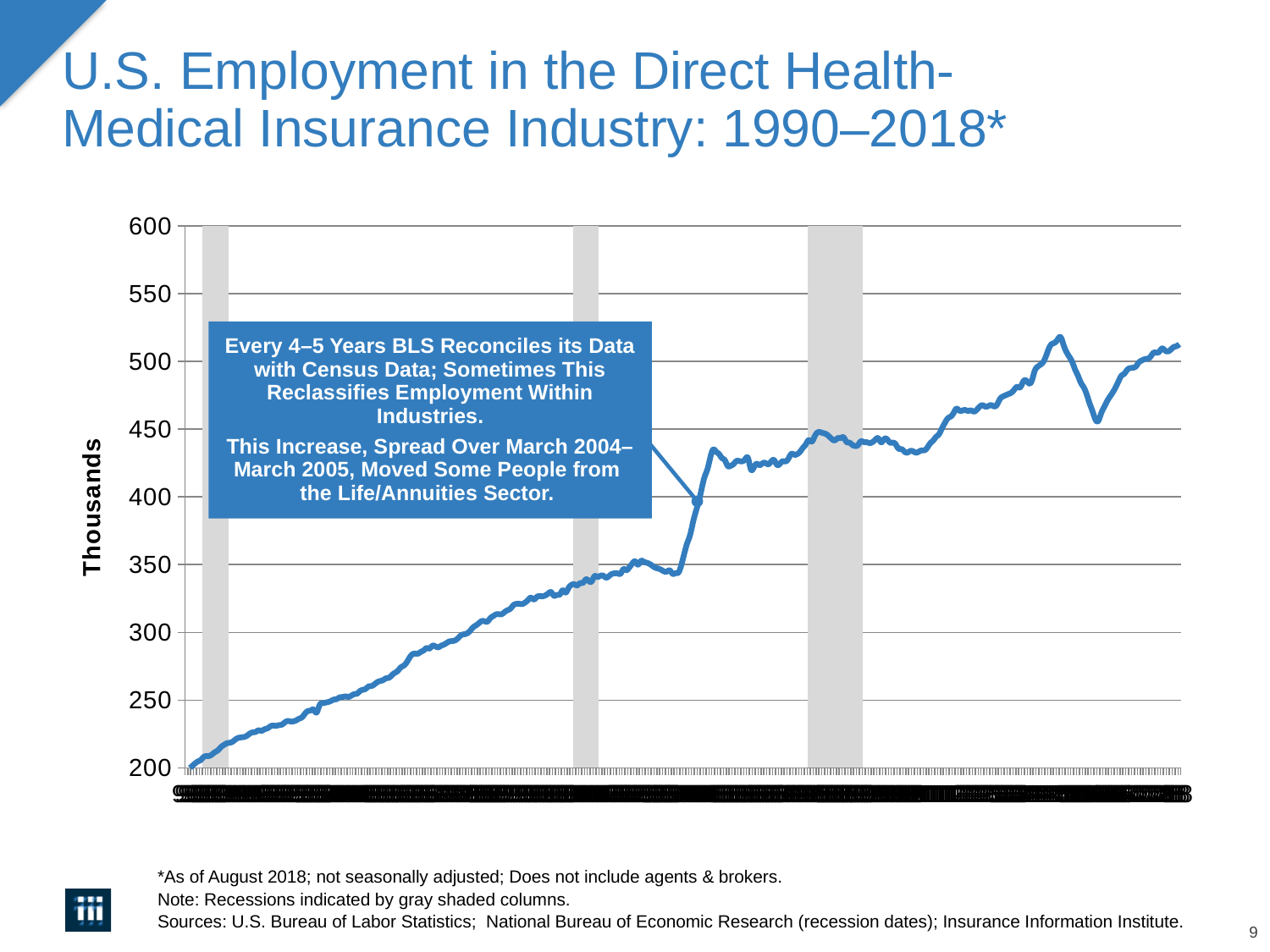
Is the lowest point of the line greater or less than 250? less Overall, do the values rise or fall from the left of the chart to the right? rise What kind of chart is shown on the slide? line chart How many gray shaded recession columns are shown on the chart? 3 What is the label on the vertical axis? Thousands Is the value at the end of the series (right end of the line) greater or less than 500? greater Is the value at the start of the series (left end of the line) greater or less than 250? less What is the highest value shown on the vertical axis? 600